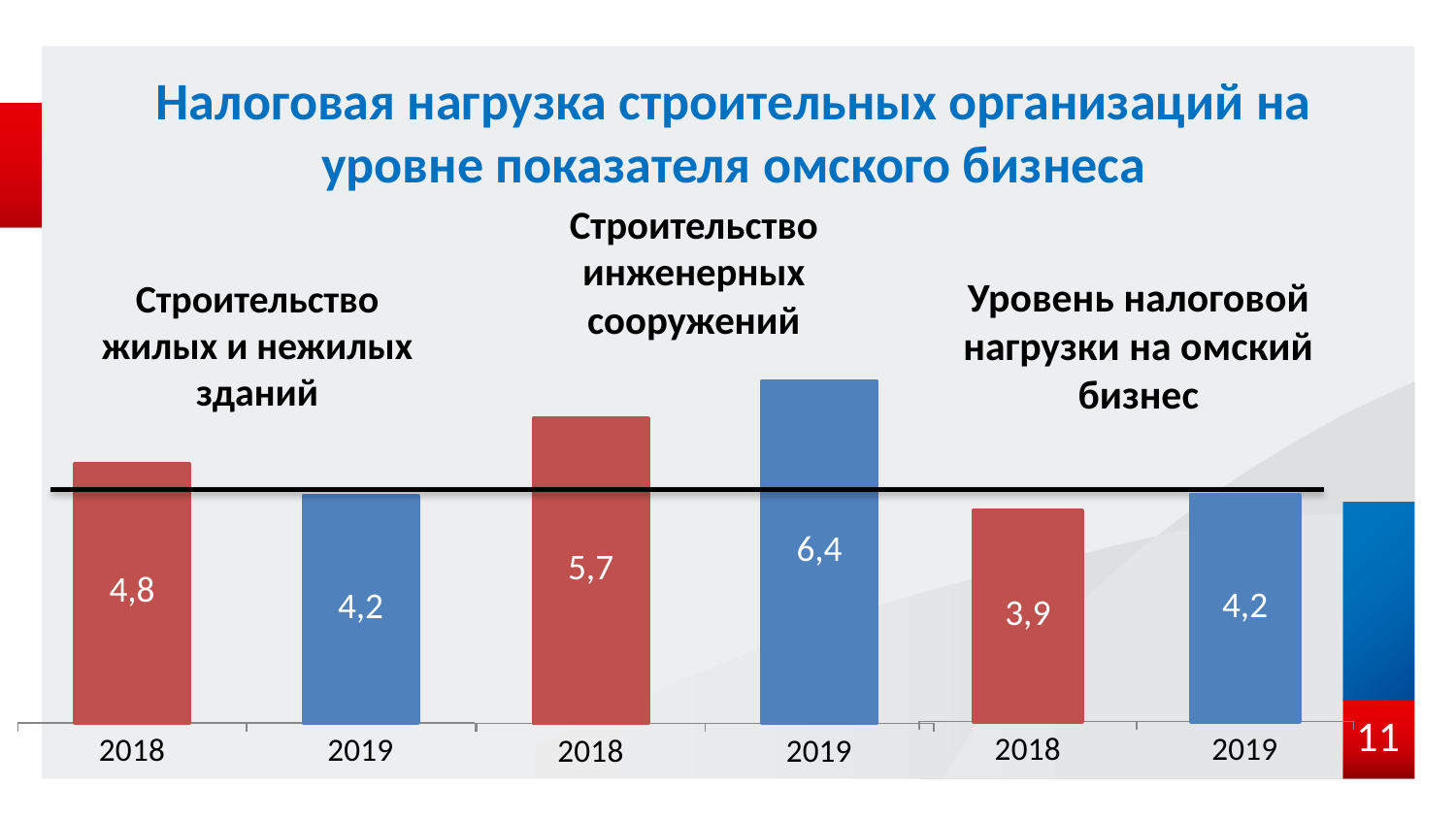
What is the difference between the 2018 and 2019 values in the group "Строительство жилых и нежилых зданий"? 0,6 What is the value for 2019 in the group "Строительство инженерных сооружений"? 6,4 Which bar has the lowest value on the chart? 2018, Уровень налоговой нагрузки на омский бизнес (3,9) What type of chart is shown on the slide? Bar chart Which is larger: the 2018 value for "Строительство жилых и нежилых зданий" or the 2018 value for "Строительство инженерных сооружений"? Строительство инженерных сооружений (5,7) What is the value for 2018 in the group "Строительство жилых и нежилых зданий"? 4,8 What is the value for 2019 in the group "Уровень налоговой нагрузки на омский бизнес"? 4,2 What is the value for 2018 in the group "Уровень налоговой нагрузки на омский бизнес"? 3,9 Which bar has the highest value on the chart? 2019, Строительство инженерных сооружений (6,4) How many bars are plotted on the chart? 6 What is the difference between the 2019 and 2018 values in the group "Строительство инженерных сооружений"? 0,7 From 2018 to 2019, does the value for "Строительство инженерных сооружений" rise or fall? Rise